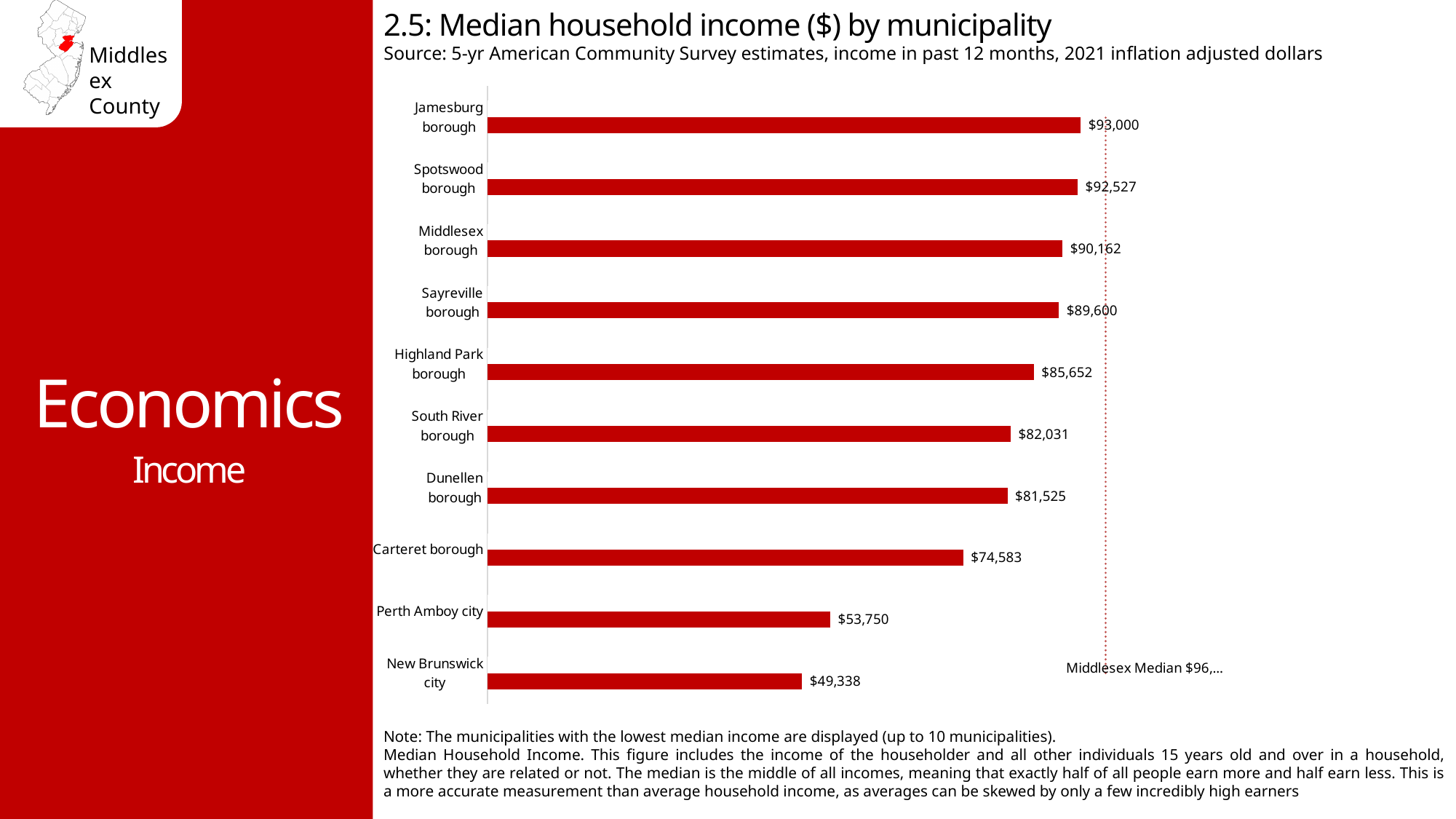
What is the difference in median household income between Jamesburg borough and New Brunswick city? $43,662 What kind of chart is used to show median household income by municipality? Bar chart Which has a higher median household income, South River borough or Dunellen borough? South River borough What is the difference in median household income between Perth Amboy city and New Brunswick city? $4,412 What is the median household income for Perth Amboy city? $53,750 What is the median household income for Highland Park borough? $85,652 Which municipality has the highest median household income shown on the chart? Jamesburg borough Which municipality has the lowest median household income shown on the chart? New Brunswick city What is the median household income for Jamesburg borough? $93,000 How many municipalities are shown on the chart? 10 What is the median household income for Carteret borough? $74,583 What is the title of the chart? 2.5: Median household income ($) by municipality